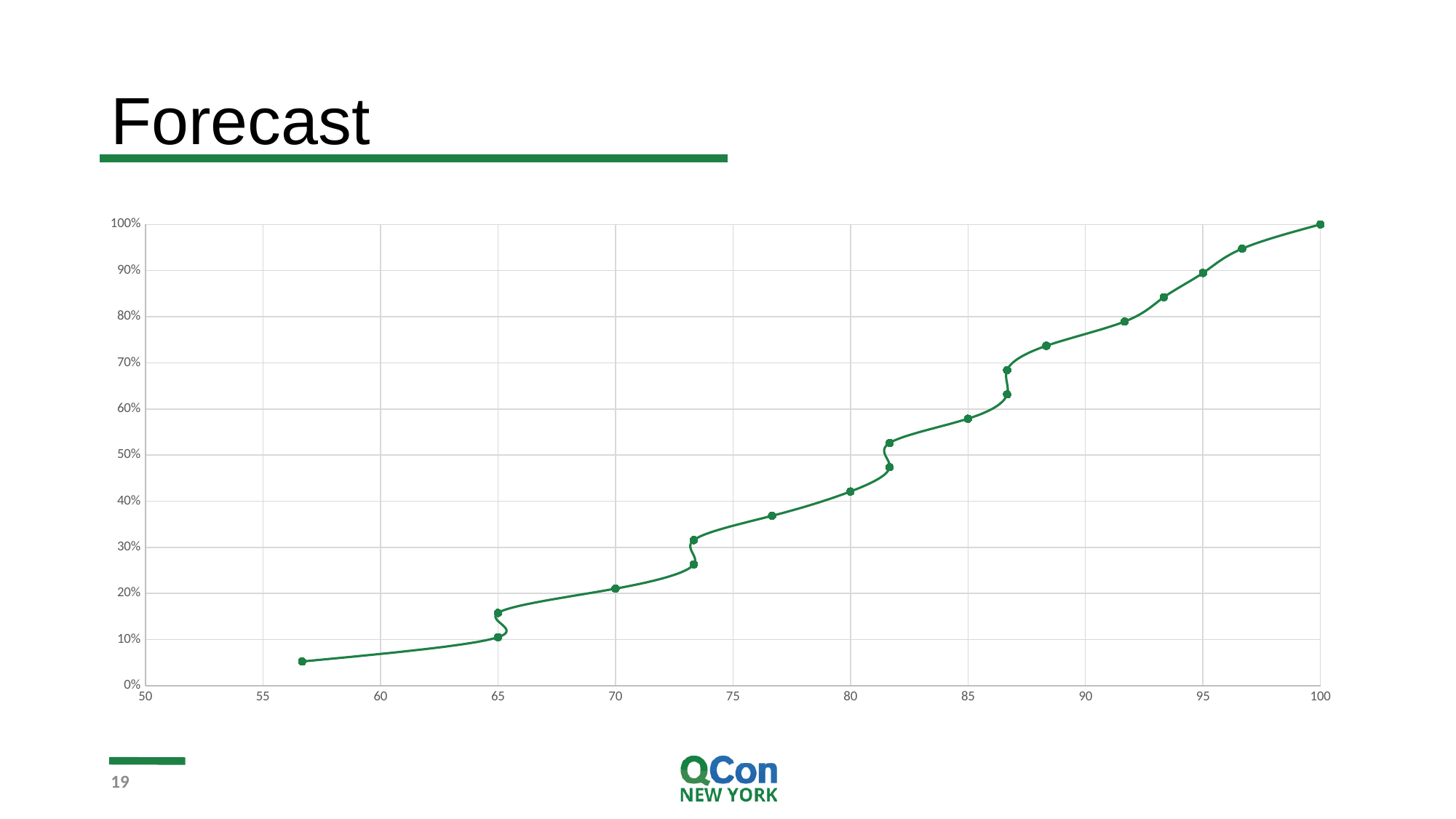
Is the y value of the leftmost point on the line greater or less than 10%? less What is the title of the chart? Forecast What colour is the plotted line? green What is the range of the x axis? 50 to 100 What kind of chart is shown on the slide? line chart Is the y value of the point at x = 85 greater or less than 60%? less At which x value does the line reach its highest y value? 100 What is the y value of the point plotted at x = 100? 100% Do the plotted values rise or fall as the x axis increases from 50 to 100? rise Which has the larger y value, the point at x = 70 or the point at x = 80? the point at x = 80 Is the y value of the point at x = 80 greater or less than 40%? greater